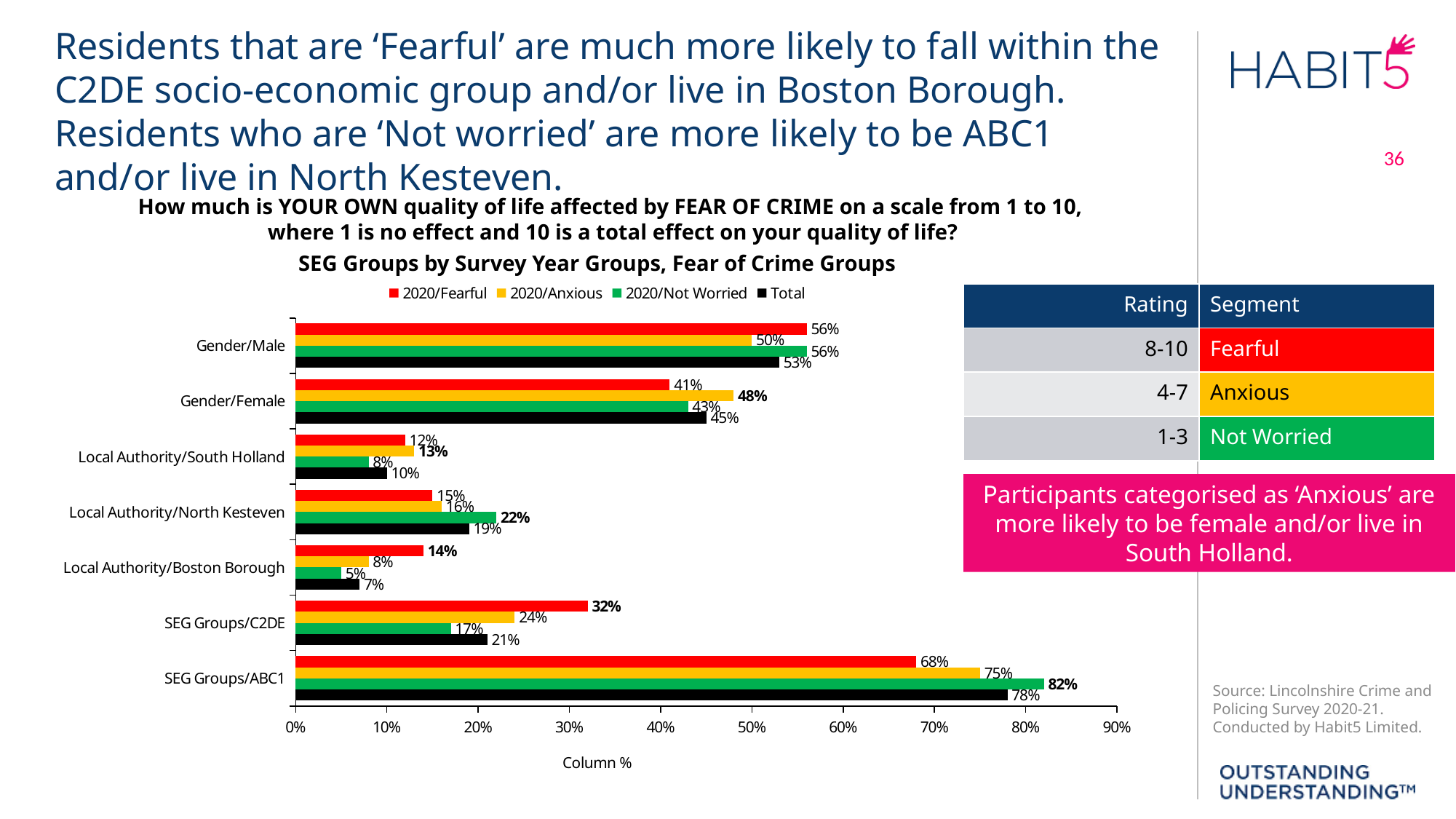
What is the Total value for Gender/Female? 45% What is the title of the chart? SEG Groups by Survey Year Groups, Fear of Crime Groups How many categories are shown on the y axis of the chart? 7 What is the 2020/Anxious value for Local Authority/South Holland? 13% What is the difference between the 2020/Fearful and 2020/Not Worried values for SEG Groups/C2DE? 15% Which category has the lowest 2020/Not Worried value? Local Authority/Boston Borough Which category has the highest 2020/Fearful value? SEG Groups/ABC1 For Local Authority/North Kesteven, which is larger: the 2020/Fearful value or the 2020/Not Worried value? 2020/Not Worried What is the 2020/Not Worried value for SEG Groups/ABC1? 82% What type of chart is shown on the slide? Bar chart What is the 2020/Fearful value for SEG Groups/C2DE? 32% How many series does the chart legend list? 4